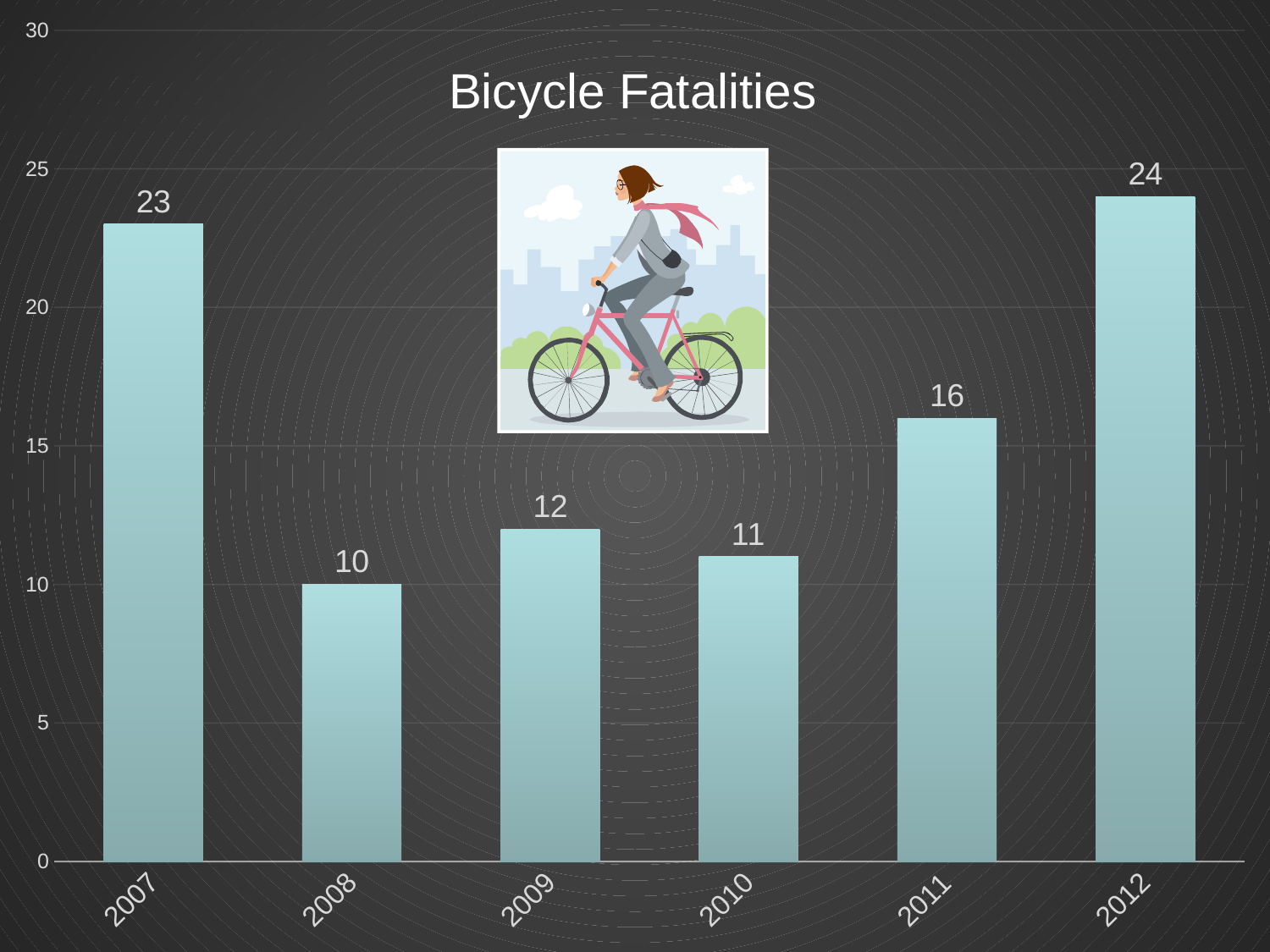
What kind of chart is this? bar chart What is the value for 2011? 16 What is the value for 2007? 23 What is the value for 2009? 12 Which year has the highest value? 2012 What is the title of the chart? Bicycle Fatalities Which year has the lowest value? 2008 How many years are shown on the x axis? 6 What is the difference between the values for 2007 and 2010? 12 What is the difference between the values for 2012 and 2008? 14 Is the value for 2011 greater or less than 15? greater Which is larger, the value for 2009 or the value for 2010? 2009